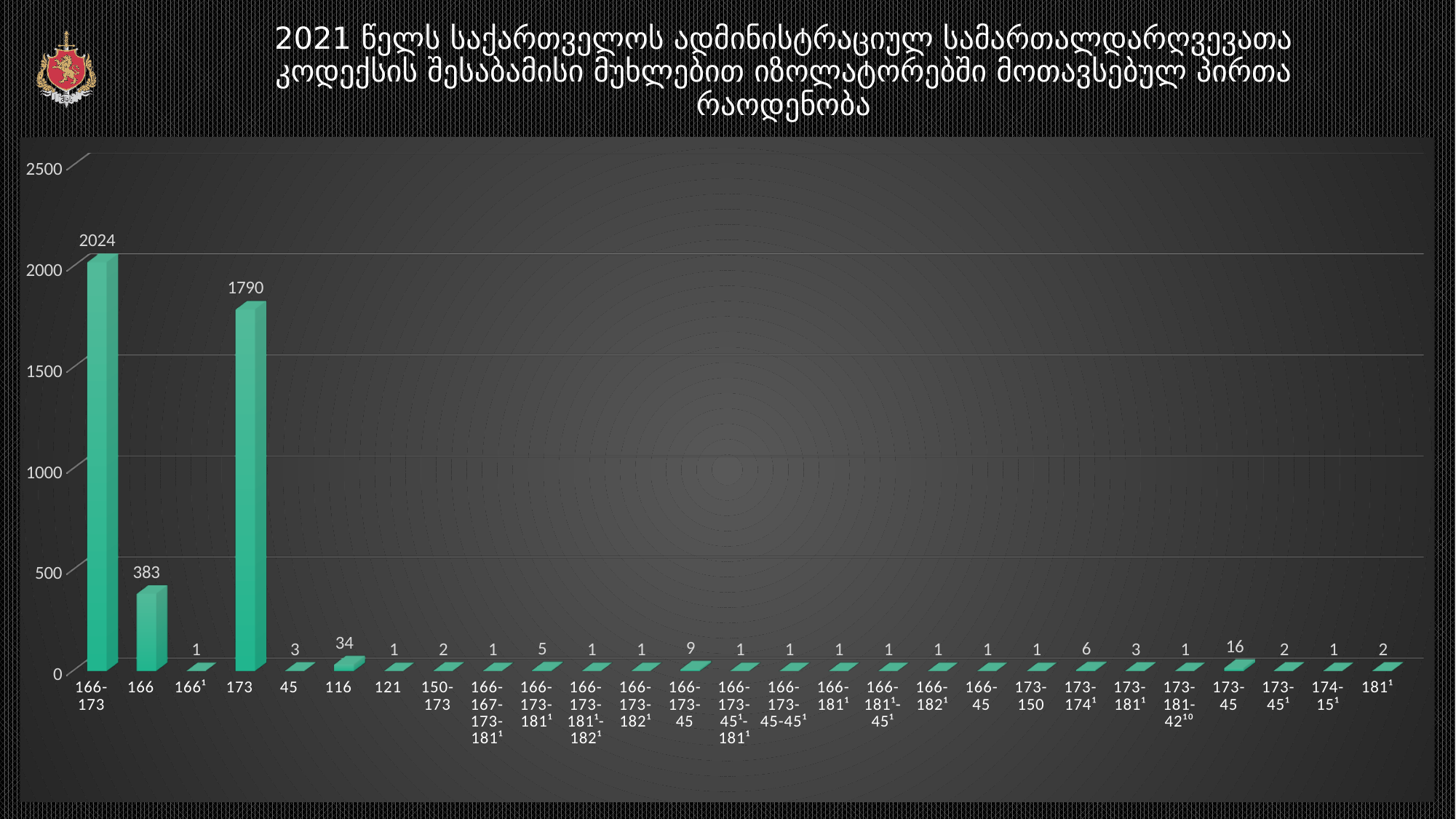
What is the difference between the values for 166 and 116? 349 Which category has the highest value? 166-173 What is the value for the category 116? 34 What kind of chart is shown on the slide? bar chart What is the difference between the values for 166-173 and 173? 234 How many categories are shown on the x axis? 27 Is the value for 166 greater or less than 500? less Which is larger, the value for 166-173-45 or the value for 173-174¹? 166-173-45 What is the value for the category 173-45? 16 What is the value for the category 173? 1790 What is the value for the category 166-173? 2024 What is the value for the category 166? 383